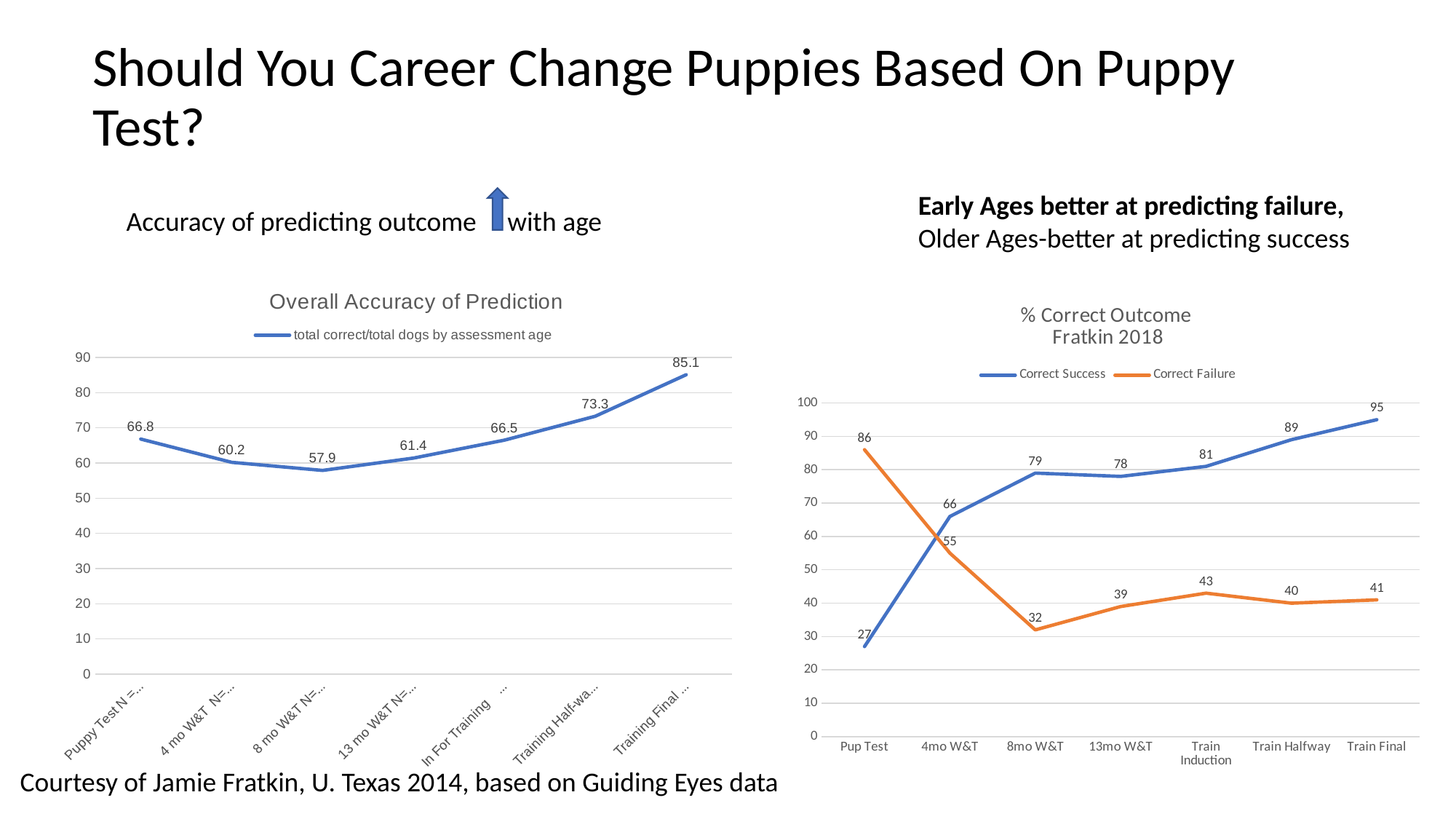
In the 'Overall Accuracy of Prediction' chart, what is the highest plotted value? 85.1 In the '% Correct Outcome Fratkin 2018' chart, at which category is Correct Failure lowest? 8mo W&T How many series does the legend of the '% Correct Outcome Fratkin 2018' chart list? 2 In the 'Overall Accuracy of Prediction' chart, what is the difference between the last point (85.1) and the first point (66.8)? 18.3 In the '% Correct Outcome Fratkin 2018' chart, what is the difference between Correct Success and Correct Failure at Train Induction? 38 In the '% Correct Outcome Fratkin 2018' chart, does the Correct Success line generally rise or fall from Pup Test to Train Final? Rise What kind of chart is the 'Overall Accuracy of Prediction' chart? Line chart In the '% Correct Outcome Fratkin 2018' chart, what is the Correct Failure value at Pup Test? 86 How many categories are plotted along the x axis of the '% Correct Outcome Fratkin 2018' chart? 7 In the '% Correct Outcome Fratkin 2018' chart, which is larger at 4mo W&T: Correct Success or Correct Failure? Correct Success In the '% Correct Outcome Fratkin 2018' chart, what is the Correct Success value at Train Final? 95 In the 'Overall Accuracy of Prediction' chart, what is the lowest plotted value? 57.9